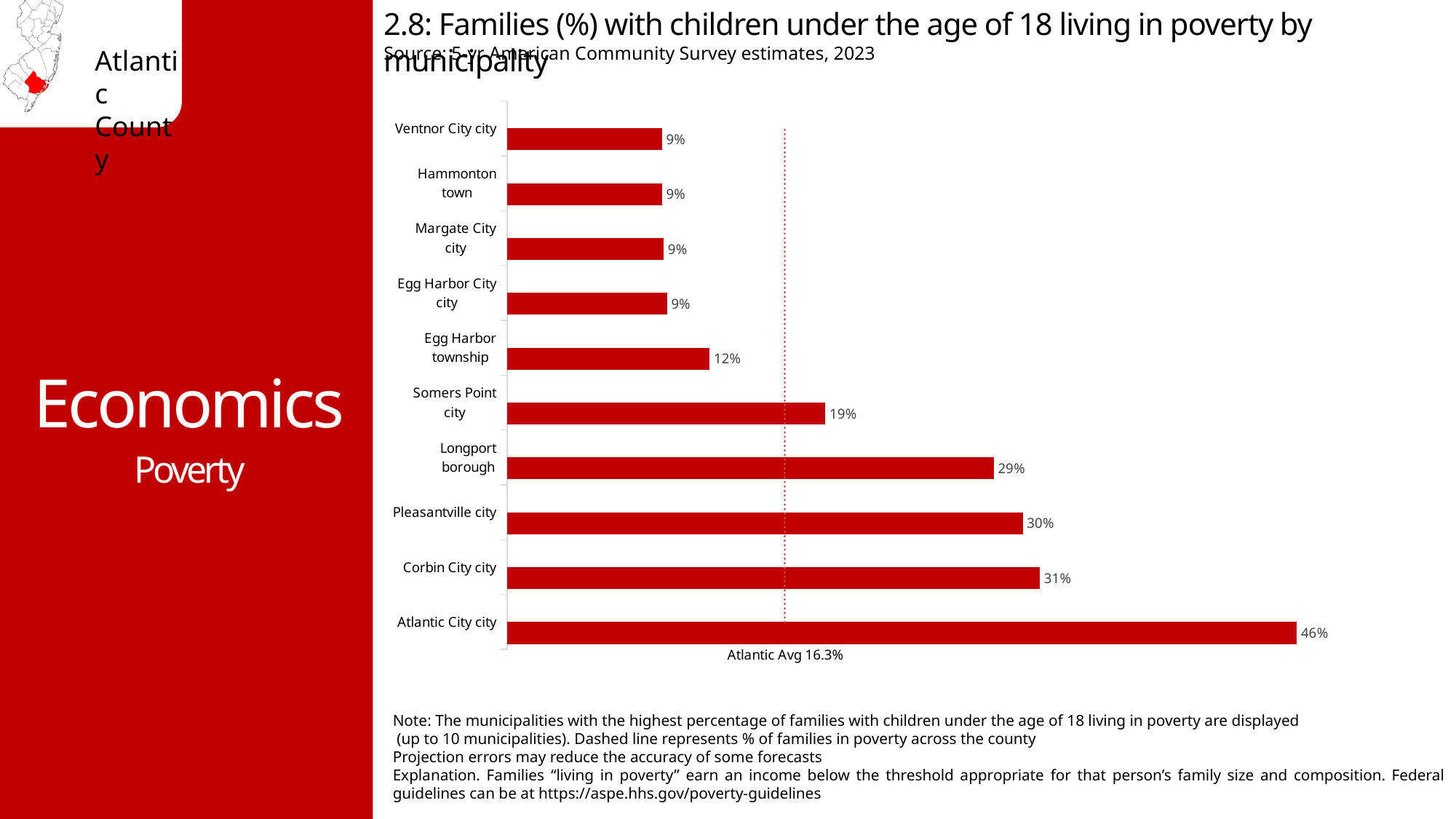
Which municipality has the highest percentage of families with children under 18 living in poverty? Atlantic City city What is the value for Somers Point city? 19% What value does the dashed line labelled Atlantic Avg represent? 16.3% What type of chart is shown on the slide? bar chart What is the value for Longport borough? 29% What is the value for Egg Harbor township? 12% What is the source of the data shown in the chart? 5-yr American Community Survey estimates, 2023 Which is larger, the value for Pleasantville city or the value for Somers Point city? Pleasantville city What is the value for Atlantic City city? 46% What is the difference between the values for Atlantic City city and Corbin City city? 15% How many municipalities are shown in the chart? 10 What is the difference between the values for Somers Point city and Egg Harbor township? 7%